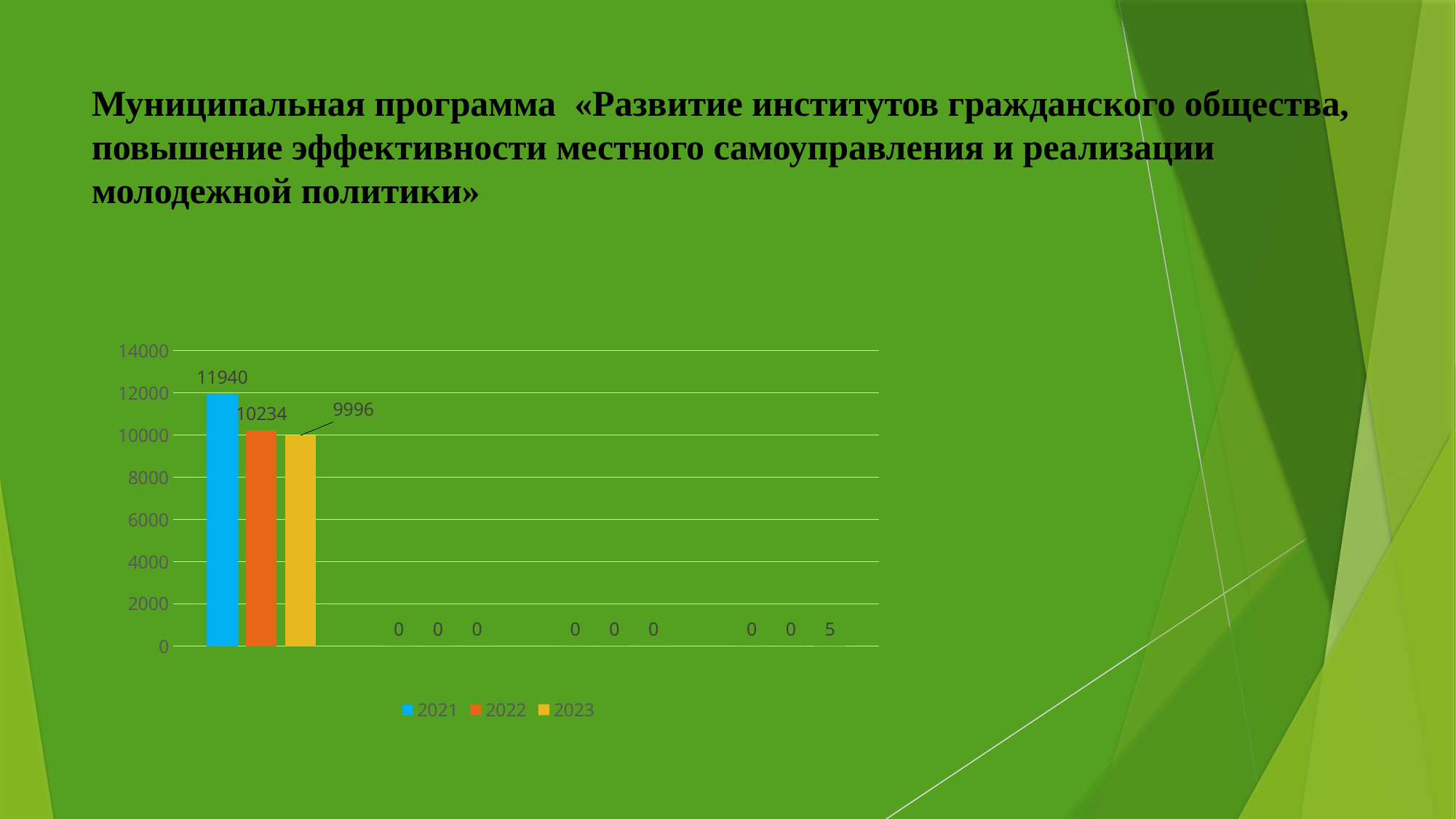
What kind of chart is shown on the slide? bar chart In the first (leftmost) group of bars, which series has the highest value? 2021 Which years are listed in the chart legend? 2021, 2022, 2023 What is the value labelled for 2023 in the rightmost (fourth) group of bars? 5 In the first group of bars, which is larger: the 2022 value or the 2023 value? 2022 What colour represents the 2021 series in the chart? blue How many series does the chart legend list? 3 In the first (leftmost) group of bars, what is the value for 2022? 10234 In the first (leftmost) group of bars, what is the value for 2021? 11940 In the first (leftmost) group of bars, what is the value for 2023? 9996 What is the difference between the 2021 value (11940) and the 2022 value (10234) in the first group of bars? 1706 In the first (leftmost) group of bars, which series has the lowest value? 2023